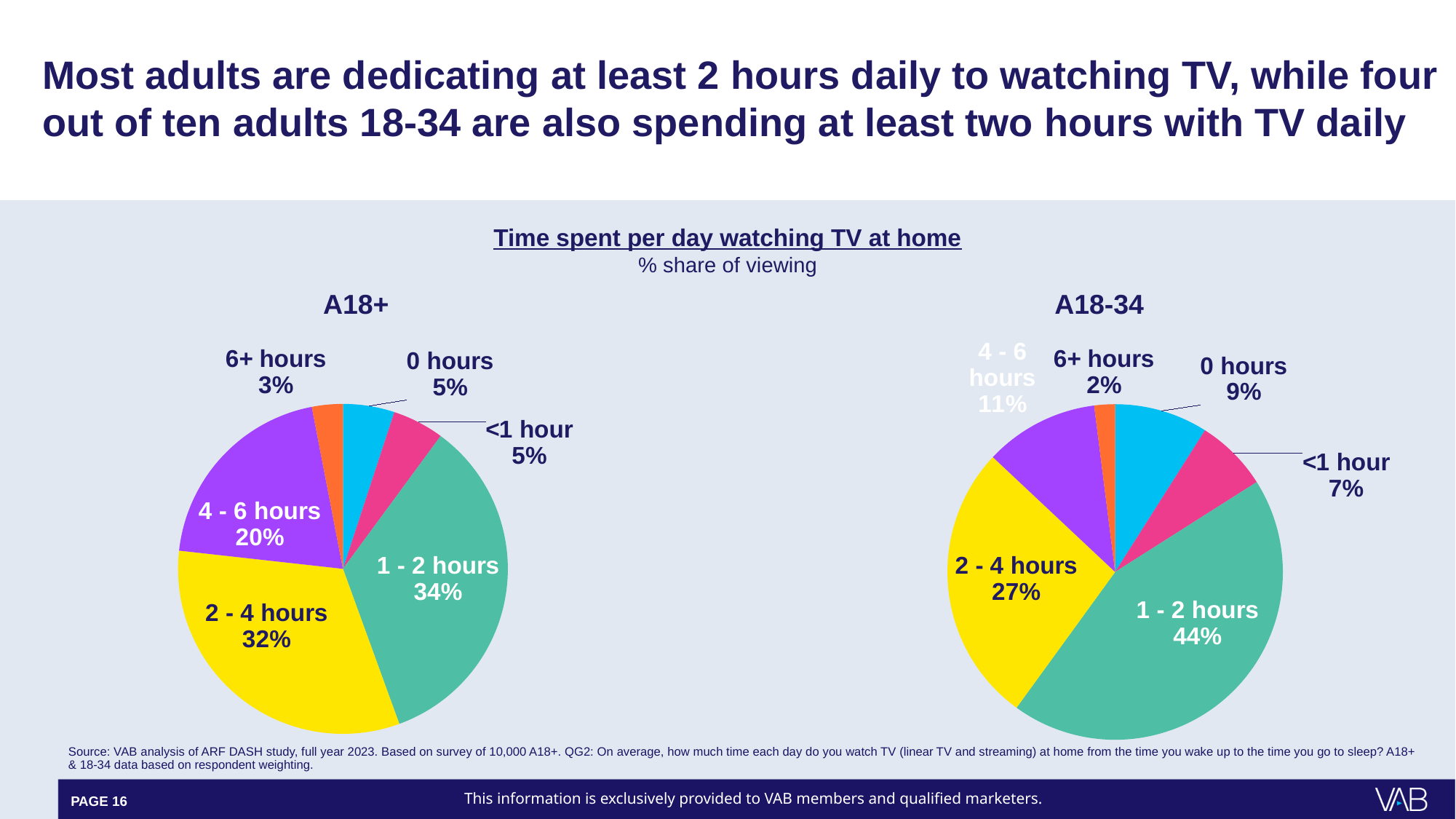
In the A18+ pie chart, what share of viewing is 4 - 6 hours? 20% In the A18+ pie chart, what share of viewing is 1 - 2 hours? 34% In the A18-34 pie chart, what share of viewing is 2 - 4 hours? 27% What type of chart is used for the A18-34 data? Pie chart In the A18+ pie chart, which category has the smallest share? 6+ hours In the A18+ pie chart, which category has the largest share? 1 - 2 hours In the A18-34 pie chart, which category has the smallest share? 6+ hours In the A18-34 pie chart, which is larger: the share for 2 - 4 hours or the share for 4 - 6 hours? 2 - 4 hours What is the difference between the 1 - 2 hours share in the A18-34 chart and the 1 - 2 hours share in the A18+ chart? 10 percentage points What is the title shown above the two pie charts? Time spent per day watching TV at home How many categories does the A18+ pie chart show? 6 In the A18-34 pie chart, what share of viewing is 0 hours? 9%